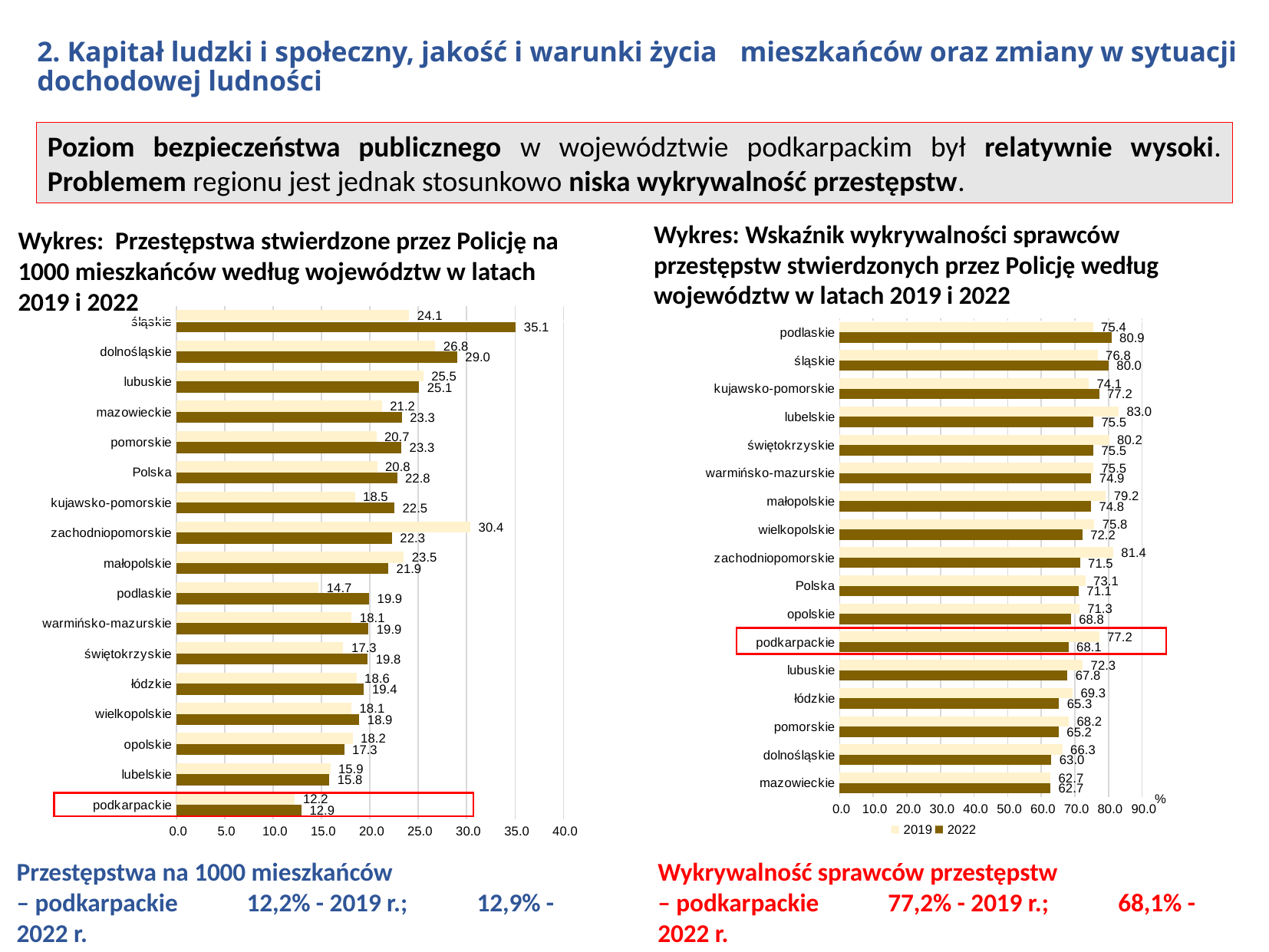
In the left chart (Przestępstwa stwierdzone przez Policję na 1000 mieszkańców), which is larger for małopolskie: the 2019 value or the 2022 value? 2019 In the right chart (Wskaźnik wykrywalności sprawców przestępstw), what is the 2022 value for mazowieckie? 62.7 In the left chart (Przestępstwa stwierdzone przez Policję na 1000 mieszkańców), how many categories are listed on the vertical axis? 17 In the right chart (Wskaźnik wykrywalności sprawców przestępstw), how many series does the legend list? 2 In the right chart (Wskaźnik wykrywalności sprawców przestępstw), what is the 2019 value for lubelskie? 83.0 In the left chart (Przestępstwa stwierdzone przez Policję na 1000 mieszkańców), what is the 2022 value for śląskie? 35.1 In the left chart (Przestępstwa stwierdzone przez Policję na 1000 mieszkańców), which województwo has the lowest 2022 value? podkarpackie What type of chart is the right chart (Wskaźnik wykrywalności sprawców przestępstw)? bar chart In the right chart (Wskaźnik wykrywalności sprawców przestępstw), what is the difference between the 2019 and 2022 values for podkarpackie? 9.1 In the left chart (Przestępstwa stwierdzone przez Policję na 1000 mieszkańców), what is the 2019 value for zachodniopomorskie? 30.4 In the left chart (Przestępstwa stwierdzone przez Policję na 1000 mieszkańców), what is the difference between the 2022 and 2019 values for podkarpackie? 0.7 In the right chart (Wskaźnik wykrywalności sprawców przestępstw), which województwo has the highest 2022 value? podlaskie